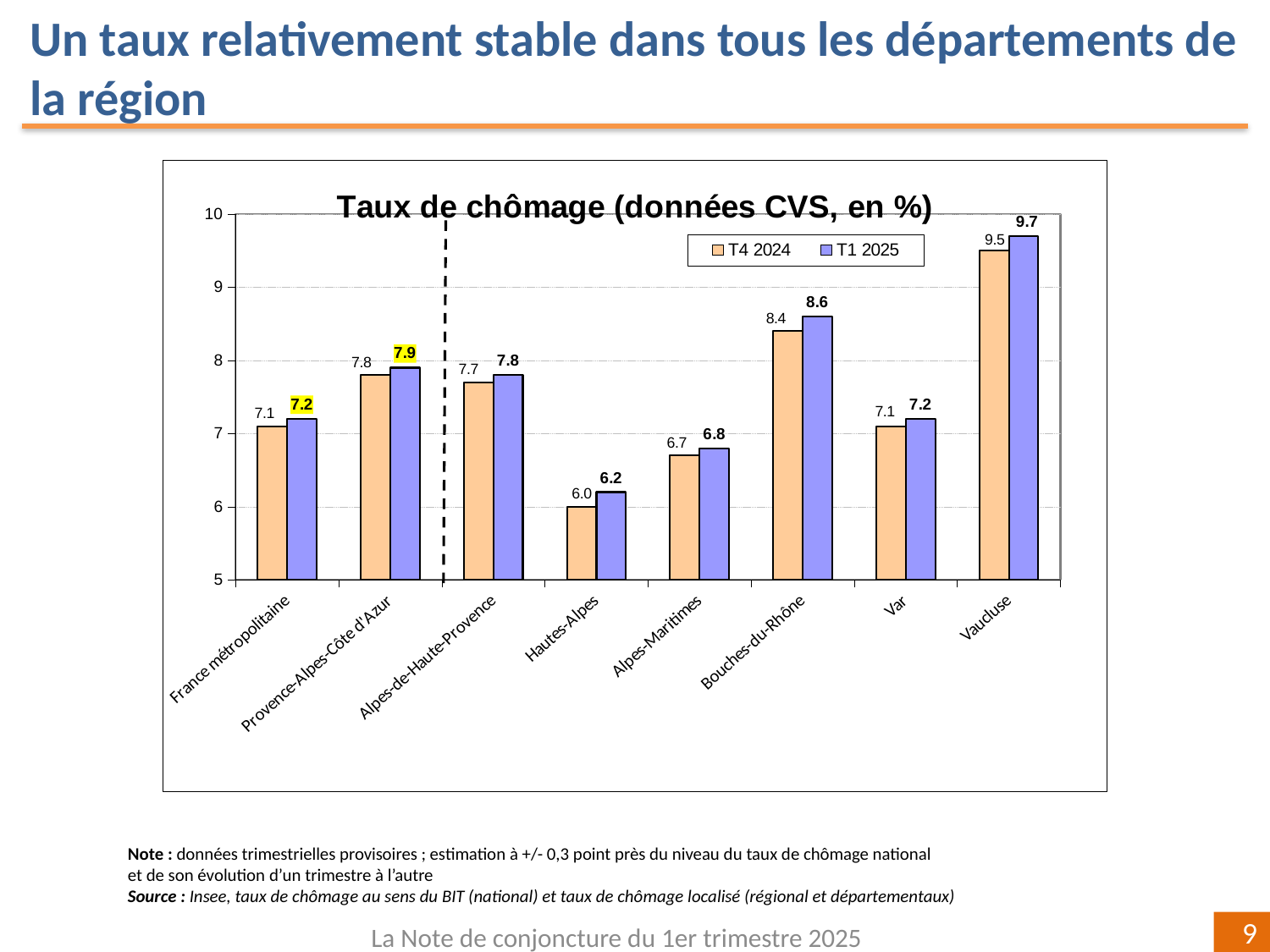
What is the T4 2024 unemployment rate for Hautes-Alpes? 6.0 Which is larger: the T1 2025 value for Var or the T1 2025 value for Alpes-Maritimes? Var What is the title of the chart? Taux de chômage (données CVS, en %) Which category has the lowest T4 2024 unemployment rate? Hautes-Alpes Is the T4 2024 value for Bouches-du-Rhône greater or less than 8? greater What is the T1 2025 value for Bouches-du-Rhône? 8.6 What kind of chart is shown on the slide? Bar chart How many categories are shown on the x axis? 8 What is the T1 2025 unemployment rate for Vaucluse? 9.7 How many series does the legend list? 2 Which category has the highest T1 2025 unemployment rate? Vaucluse What is the difference between the T1 2025 and T4 2024 values for Hautes-Alpes? 0.2